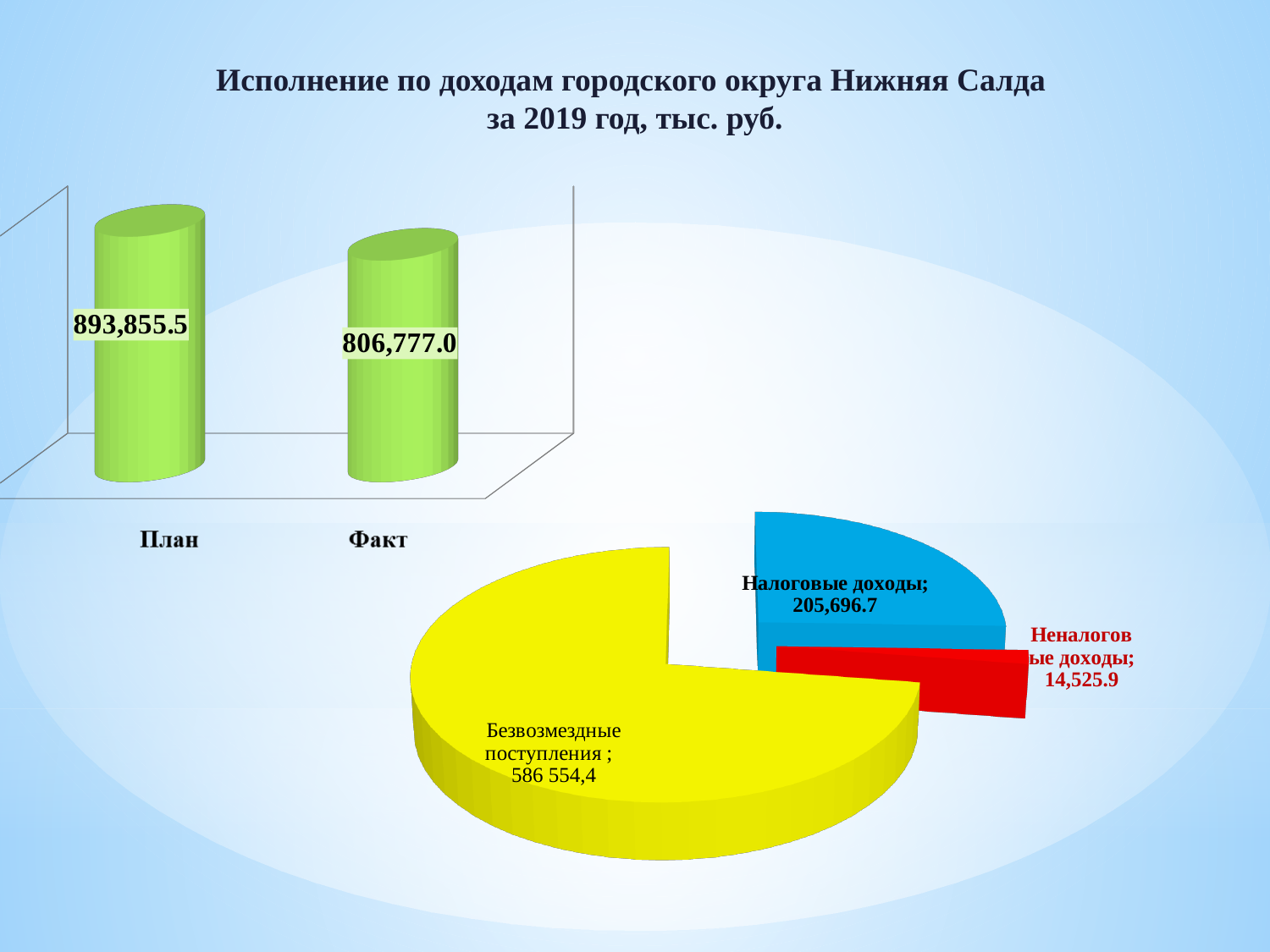
On the bar chart (План / Факт), what is the value for План? 893,855.5 On the bar chart (План / Факт), what is the difference between План and Факт? 87,078.5 On the bar chart (План / Факт), how many bars are shown? 2 On the pie chart, what is the value for Безвозмездные поступления? 586 554,4 On the pie chart, what is the value for Налоговые доходы? 205,696.7 On the pie chart, which slice is the largest? Безвозмездные поступления On the pie chart, what colour is the slice for Налоговые доходы? Blue On the pie chart, what is the value for Неналоговые доходы? 14,525.9 On the bar chart (План / Факт), what is the value for Факт? 806,777.0 On the bar chart (План / Факт), which category has the higher value? План What kind of chart is the chart in the upper left of the slide? Bar chart On the pie chart, which slice is the smallest? Неналоговые доходы